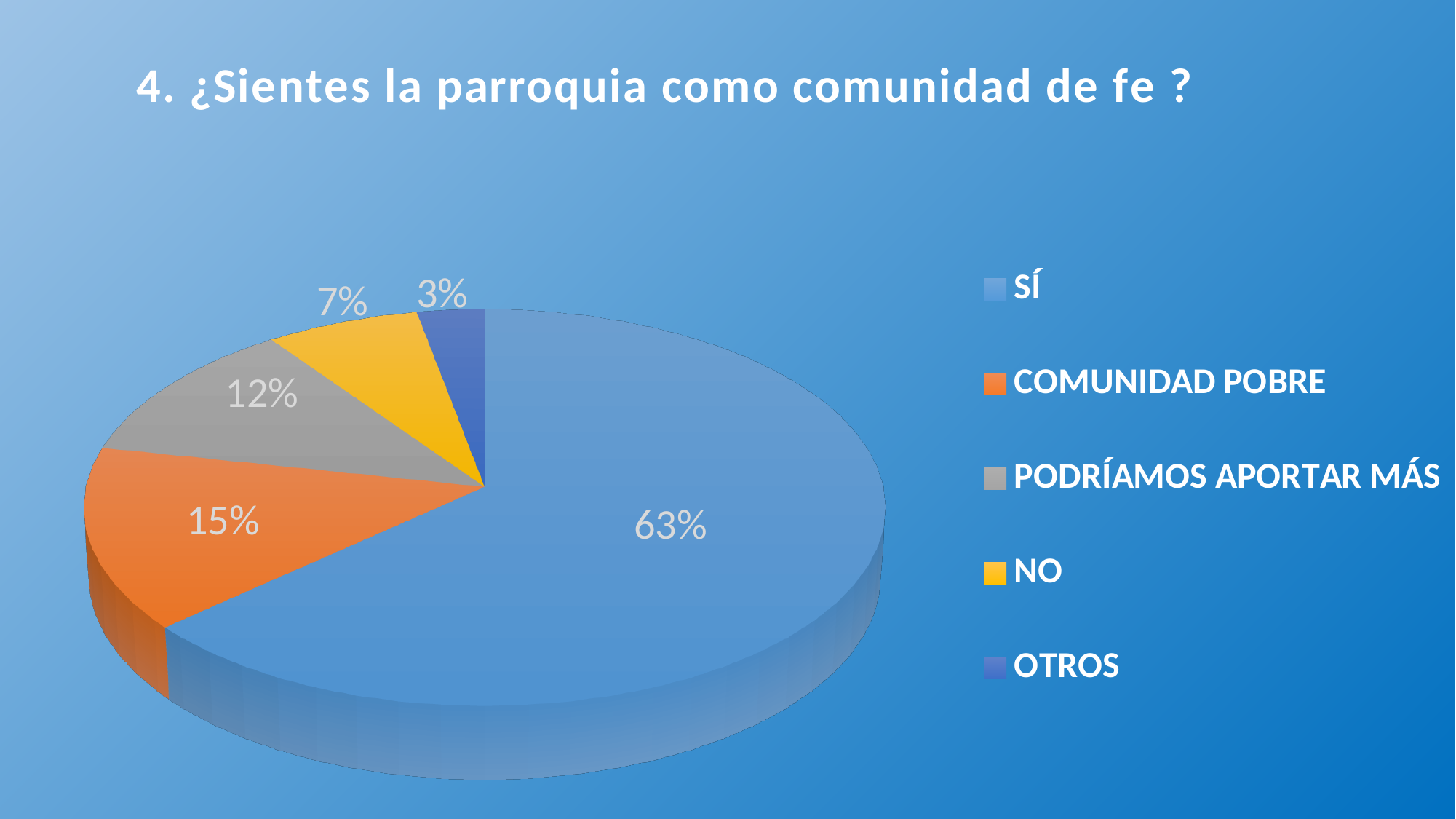
Which category has the largest share of the pie chart? SÍ What kind of chart is shown on the slide? Pie chart How many categories are shown in the pie chart? 5 Which category has the smallest share of the pie chart? OTROS What percentage of the pie chart corresponds to COMUNIDAD POBRE? 15% What is the title of the chart? 4. ¿Sientes la parroquia como comunidad de fe ? What percentage of the pie chart corresponds to PODRÍAMOS APORTAR MÁS? 12% What percentage of the pie chart corresponds to OTROS? 3% What percentage of the pie chart corresponds to SÍ? 63% What percentage of the pie chart corresponds to NO? 7% What is the difference in percentage points between SÍ and COMUNIDAD POBRE? 48 Which is larger, the share for NO or the share for PODRÍAMOS APORTAR MÁS? PODRÍAMOS APORTAR MÁS